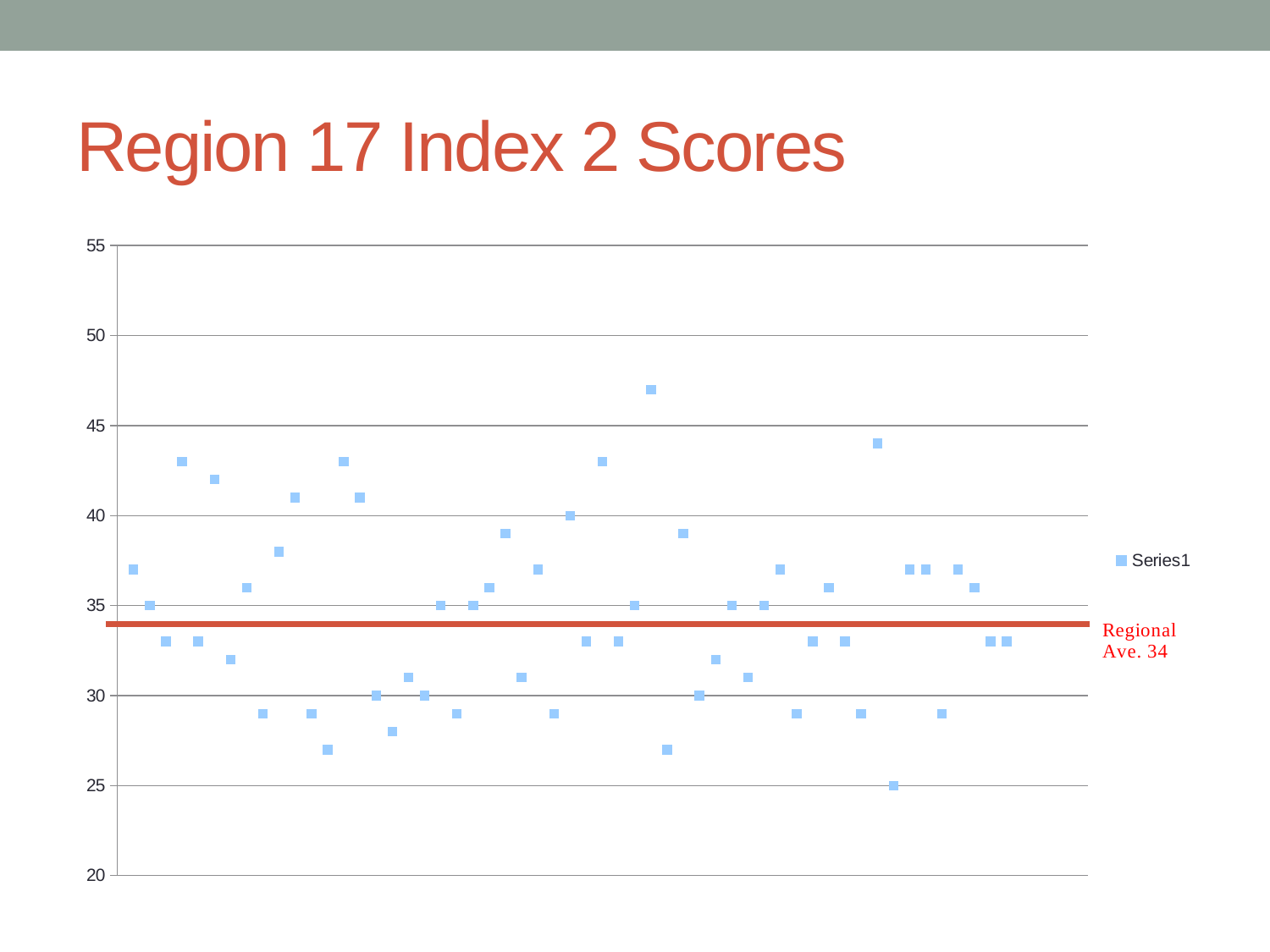
How many series does the legend list? 1 What is the lowest value shown on the vertical axis? 20 What is the name of the series shown in the legend? Series1 Is the regional average line greater or less than 35? less What kind of chart is shown on the slide? scatter chart Is the highest plotted score greater or less than 45? greater What is the title of the slide's chart? Region 17 Index 2 Scores Is the lowest plotted score greater or less than 30? less What value does the red horizontal line labelled 'Regional Ave.' represent? 34